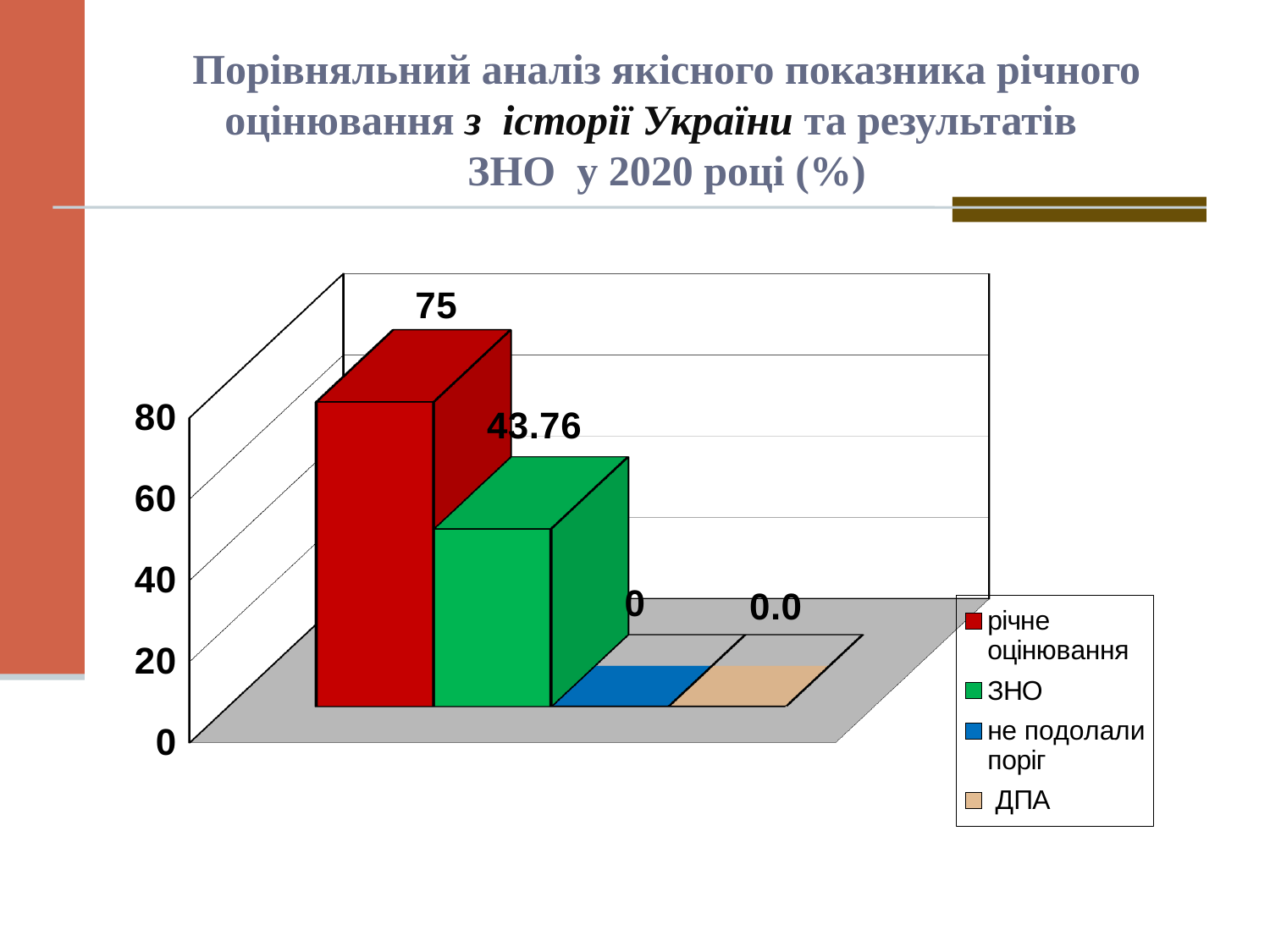
What kind of chart is shown on the slide? bar chart Is the value for ЗНО greater or less than 60? less Which series has the highest value? річне оцінювання What is the value for річне оцінювання? 75 What colour is the bar for ЗНО? green How many series does the legend list? 4 Which is larger, the value for річне оцінювання or the value for ЗНО? річне оцінювання What is the difference between the values for річне оцінювання and ЗНО? 31.24 What is the value for ДПА? 0.0 Is the value for річне оцінювання greater or less than 60? greater What is the value for не подолали поріг? 0 What is the value for ЗНО? 43.76